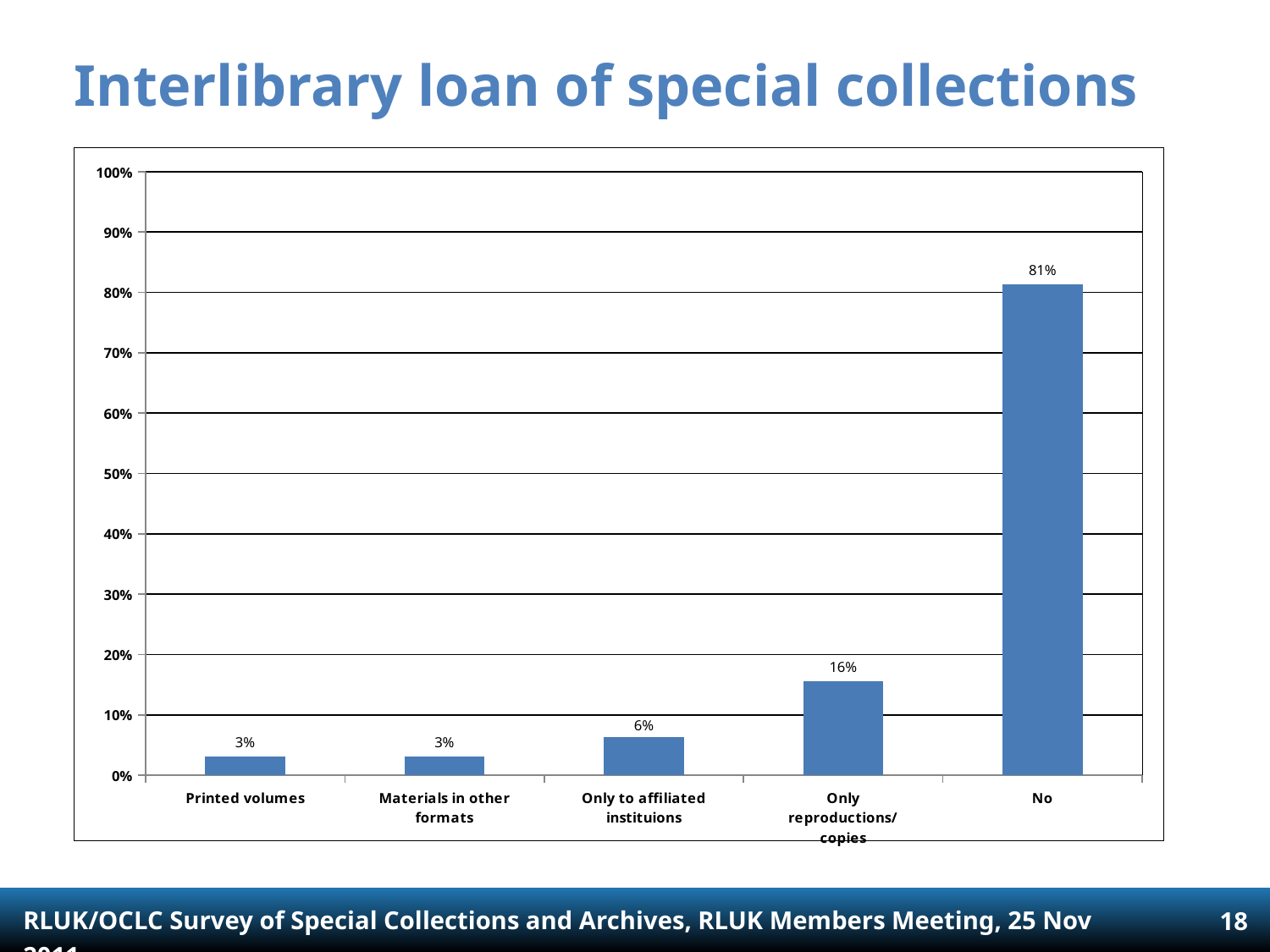
What is the value for "Printed volumes"? 3% Is the value for "No" greater or less than 80%? greater What is the difference between the values for "No" and "Only reproductions/ copies"? 65% How many categories are shown on the x axis? 5 What kind of chart is shown on the slide? bar chart What is the value for "No"? 81% Which category has the highest value? No Which is larger, the value for "Only to affiliated instituions" or the value for "Only reproductions/ copies"? Only reproductions/ copies What is the value for "Only to affiliated instituions"? 6% What is the title of the slide? Interlibrary loan of special collections What is the value for "Only reproductions/ copies"? 16% What is the difference between the values for "Only reproductions/ copies" and "Only to affiliated instituions"? 10%